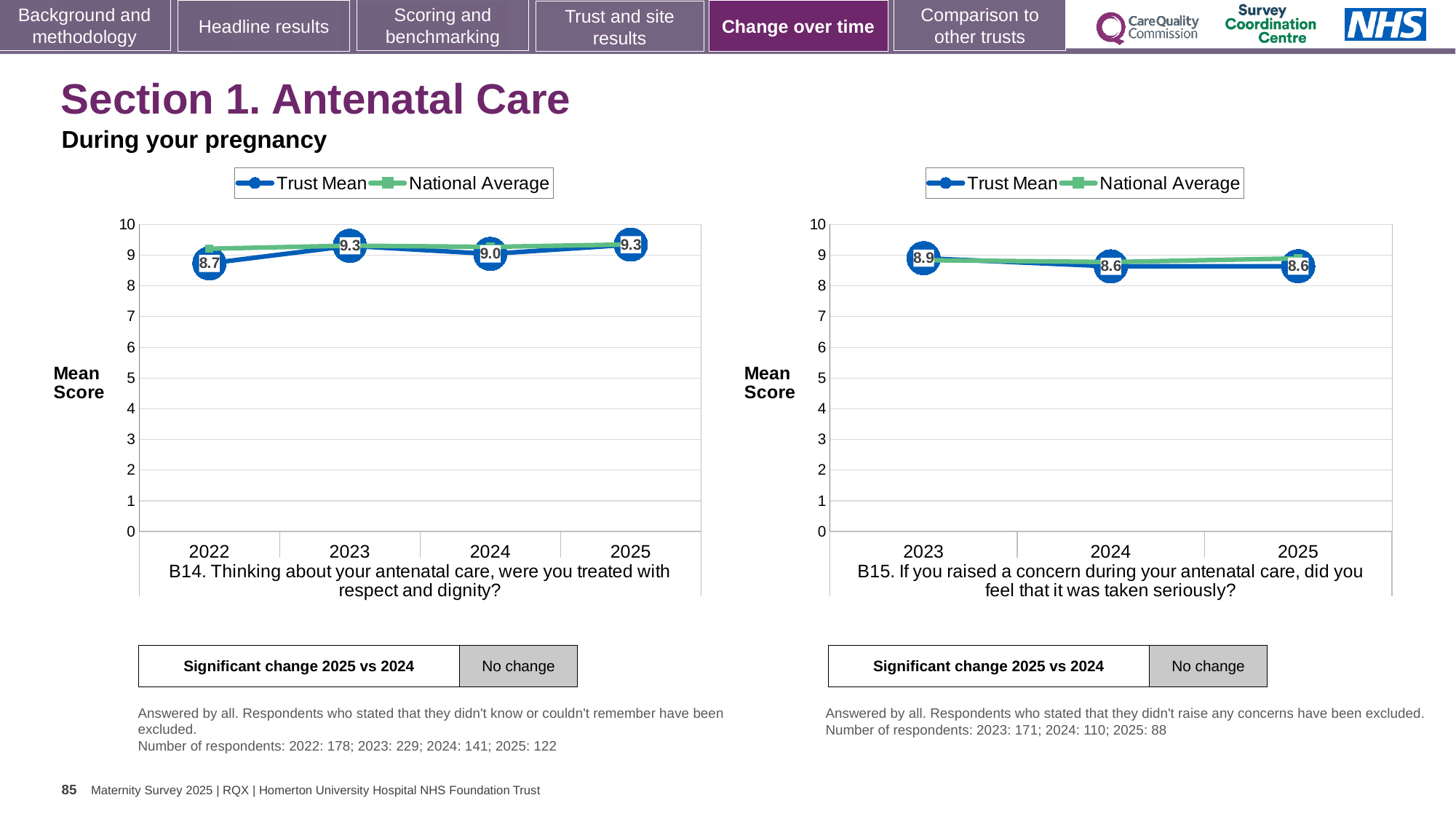
How many years are shown on the x axis of the B15 chart on the right? 3 How many series does the legend of the B14 chart on the left list? 2 In the B14 chart on the left, what is the difference between the Trust Mean for 2023 and the Trust Mean for 2022? 0.6 In the B15 chart on the right, what is the Trust Mean for 2023? 8.9 In the B15 chart on the right, which year has the highest Trust Mean? 2023 In the B14 chart on the left, what is the Trust Mean for 2024? 9.0 In the B14 chart on the left, is the National Average for 2022 greater or less than 8? greater In the B15 chart on the right, what is the Trust Mean for 2025? 8.6 In the B14 chart on the left, what is the Trust Mean for 2022? 8.7 In the B14 chart on the left, which year has the lowest Trust Mean? 2022 What kind of chart is the B14 chart on the left? Line chart In the B15 chart on the right, is the Trust Mean for 2023 larger or smaller than the Trust Mean for 2024? larger